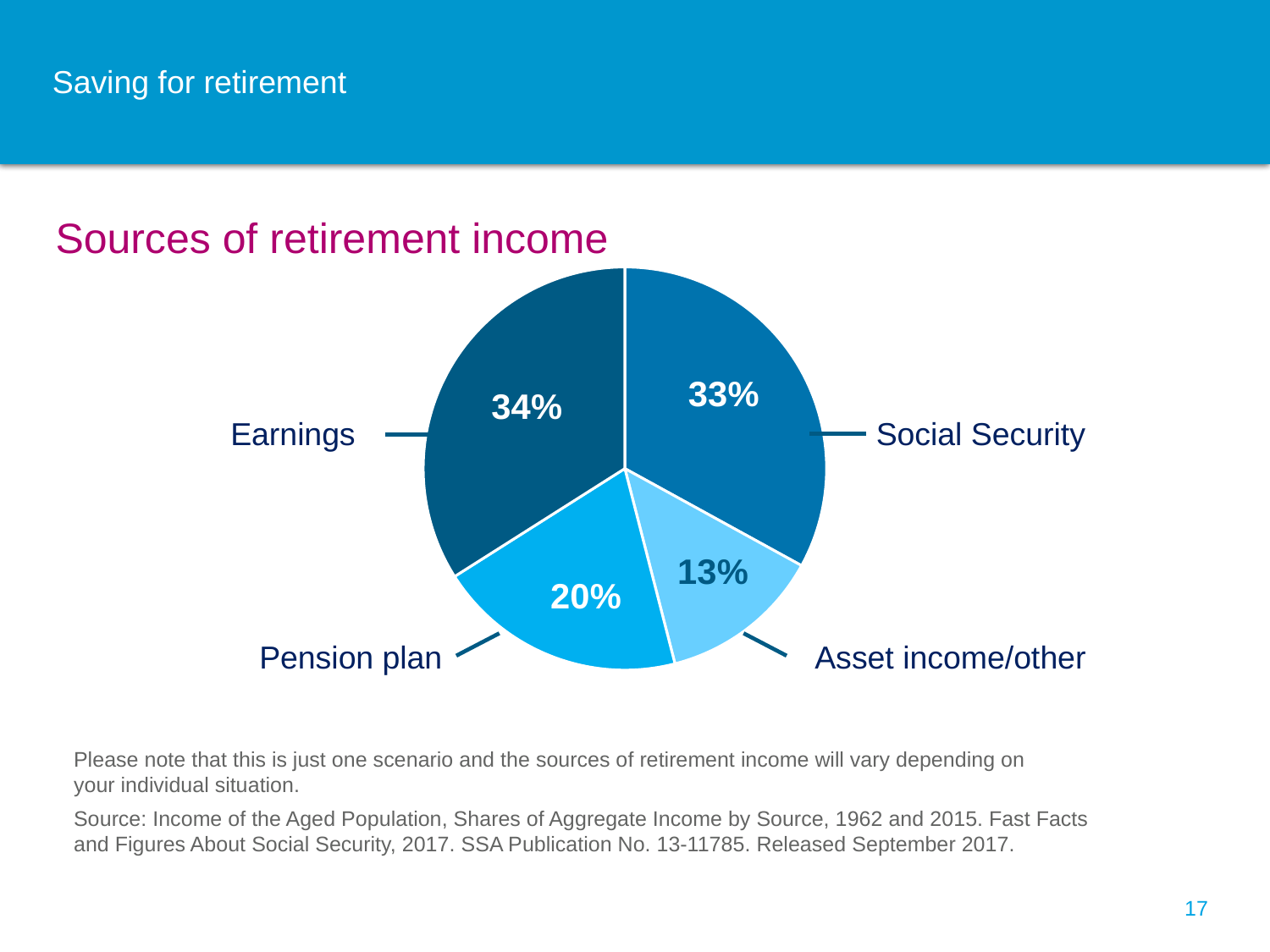
What is the difference in percentage points between the Earnings share and the Pension plan share? 14 What share of retirement income comes from Asset income/other? 13% How many sources of retirement income are shown in the pie chart? 4 What share of retirement income comes from Social Security? 33% What is the difference in percentage points between the Pension plan share and the Asset income/other share? 7 Which is larger, the Pension plan share or the Asset income/other share? Pension plan What is the title of the chart? Sources of retirement income What share of retirement income comes from Pension plan? 20% What is the combined share of Social Security and Pension plan? 53% What kind of chart is shown on the slide? Pie chart Which source has the smallest share of retirement income? Asset income/other What share of retirement income comes from Earnings? 34%